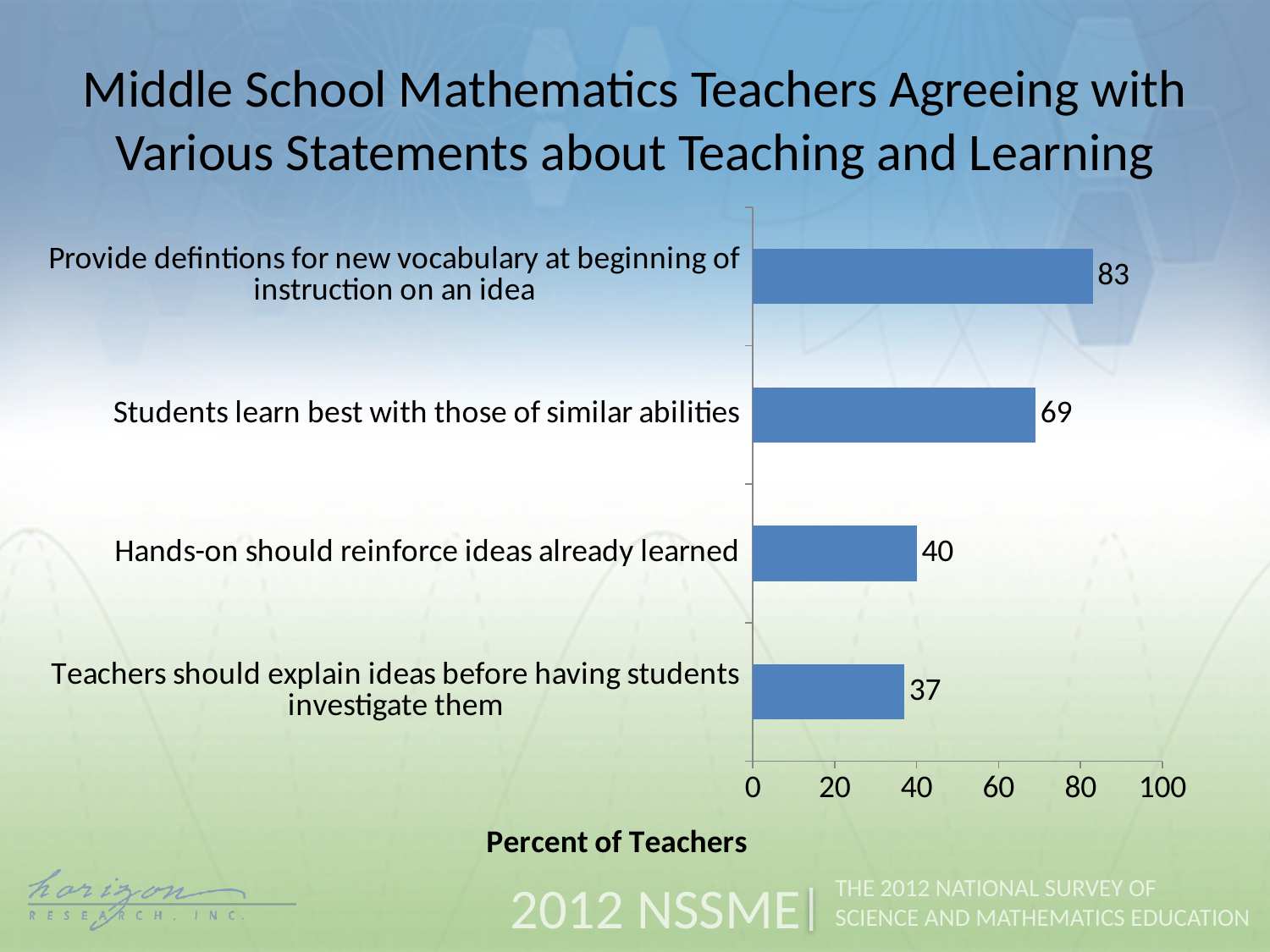
What percent of teachers agree that teachers should explain ideas before having students investigate them? 37 What kind of chart is shown on the slide? Bar chart What percent of teachers agree that they should provide definitions for new vocabulary at the beginning of instruction on an idea? 83 What percent of teachers agree that hands-on should reinforce ideas already learned? 40 What is the difference in percent of teachers between 'Hands-on should reinforce ideas already learned' and 'Teachers should explain ideas before having students investigate them'? 3 Which statement has the highest percent of teachers agreeing? Provide defintions for new vocabulary at beginning of instruction on an idea How many statements are shown in the chart? 4 Which has a larger percent of teachers agreeing: 'Students learn best with those of similar abilities' or 'Hands-on should reinforce ideas already learned'? Students learn best with those of similar abilities What percent of teachers agree that students learn best with those of similar abilities? 69 What is the label of the horizontal axis? Percent of Teachers What is the difference in percent of teachers between 'Provide defintions for new vocabulary at beginning of instruction on an idea' and 'Students learn best with those of similar abilities'? 14 Which statement has the lowest percent of teachers agreeing? Teachers should explain ideas before having students investigate them